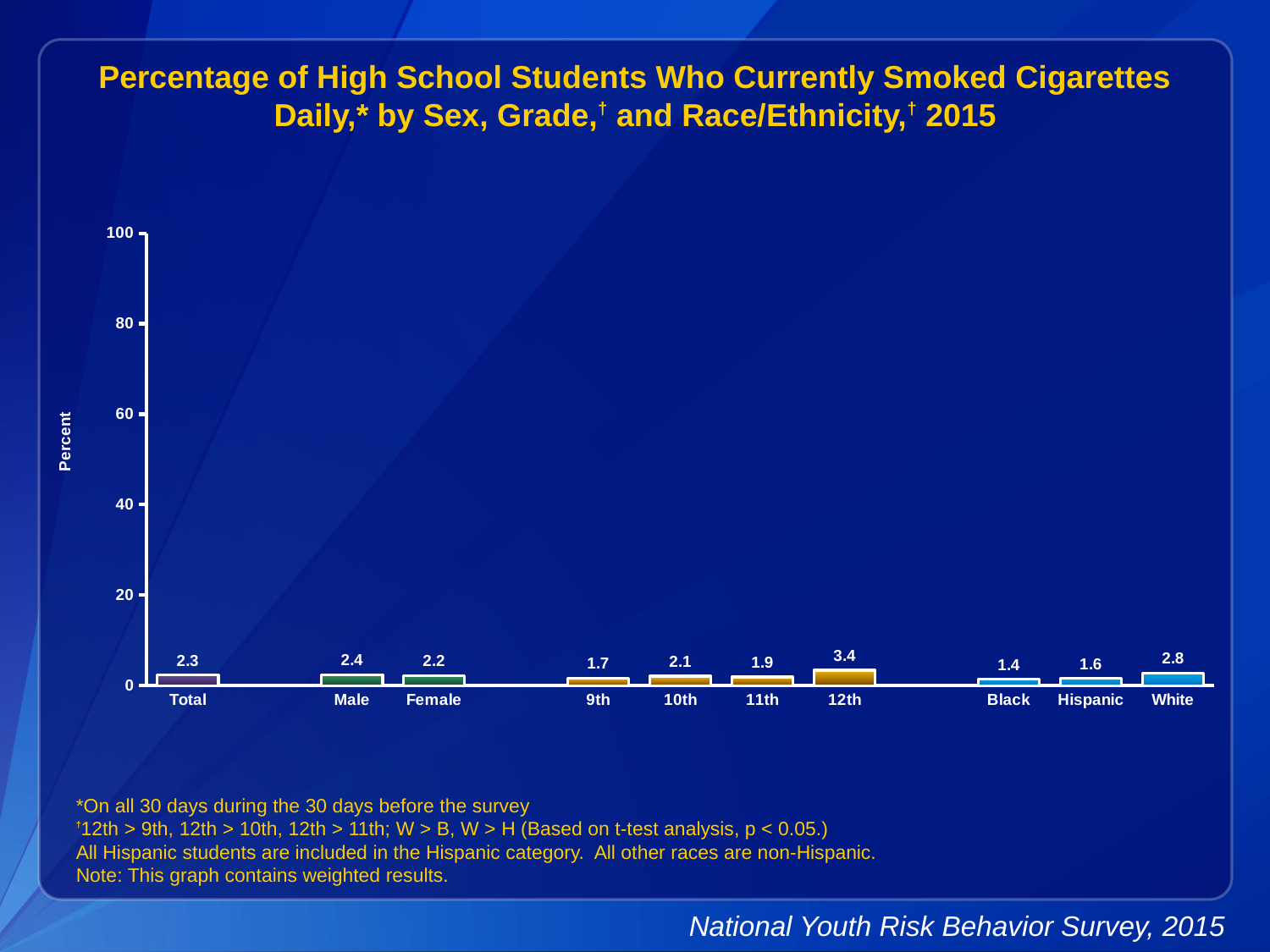
What is the value for Hispanic? 1.6 Which category has the lowest value? Black Which is larger, the value for 10th grade or 11th grade? 10th What is the value for 12th grade? 3.4 What is the value for Male? 2.4 Is the value for 12th grade greater or less than 20? less What is the difference between the values for White and Black? 1.4 Which category has the highest value? 12th What kind of chart is this? bar chart How many categories are shown on the x axis? 10 What is the difference between the values for Male and Female? 0.2 What is the value for Total? 2.3